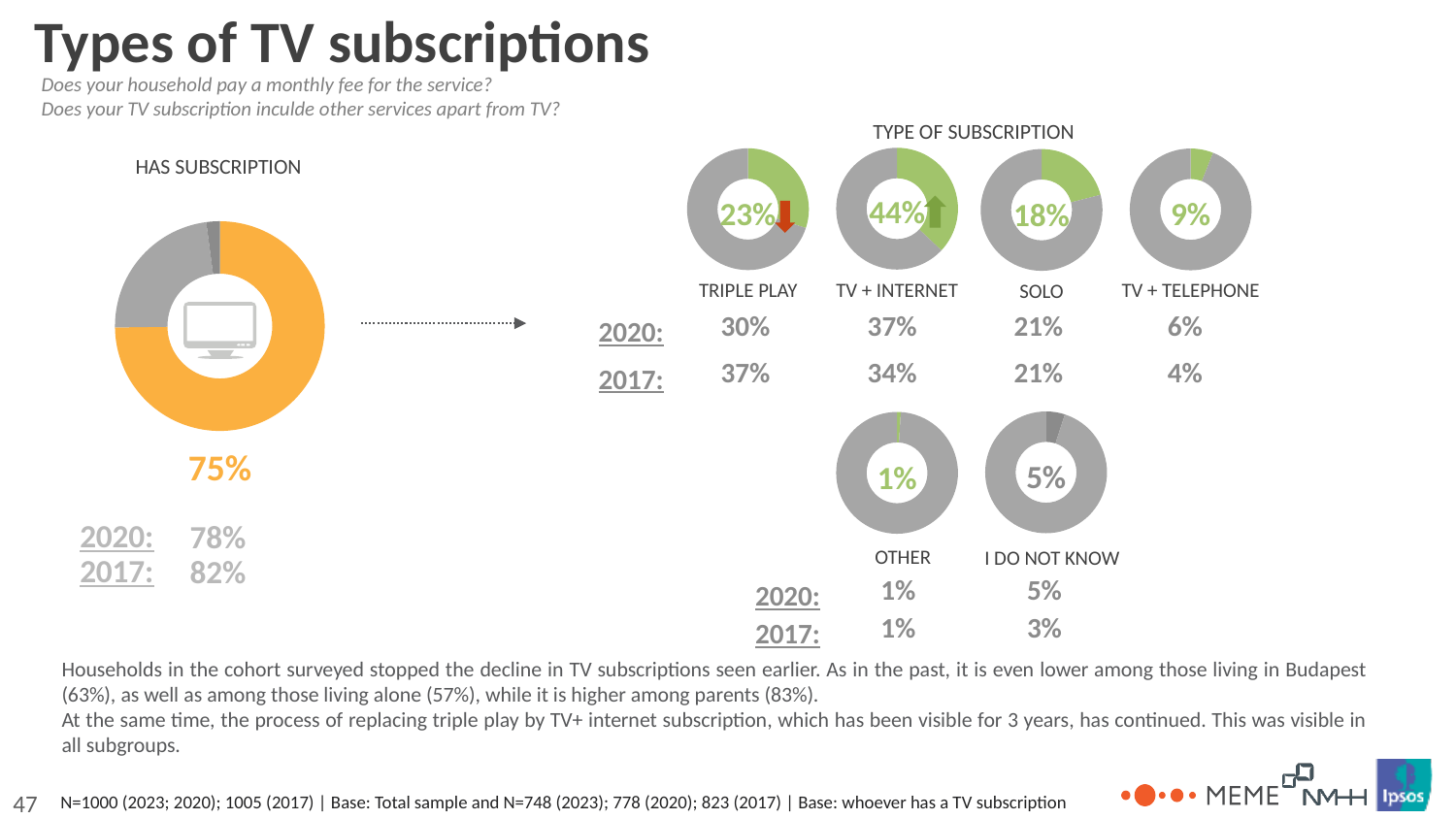
In the TYPE OF SUBSCRIPTION charts, what is the value for TRIPLE PLAY? 23% In the TYPE OF SUBSCRIPTION charts, what is the value for TV + TELEPHONE? 9% In the TYPE OF SUBSCRIPTION charts, what is the value for TV + INTERNET? 44% How many donut charts are shown under the TYPE OF SUBSCRIPTION heading? 6 Among the TYPE OF SUBSCRIPTION charts, which category has the lowest value? OTHER In the TYPE OF SUBSCRIPTION charts, which is larger: SOLO or TV + TELEPHONE? SOLO In the TYPE OF SUBSCRIPTION charts, what is the value for I DO NOT KNOW? 5% What kind of chart is used to show HAS SUBSCRIPTION? Donut (pie) chart Among the TYPE OF SUBSCRIPTION charts, which subscription type has the highest value? TV + INTERNET In the HAS SUBSCRIPTION donut chart, what share of households has a TV subscription? 75% In the TYPE OF SUBSCRIPTION charts, what is the value for SOLO? 18% In the TYPE OF SUBSCRIPTION charts, what is the difference between the TV + INTERNET value and the TRIPLE PLAY value? 21 percentage points